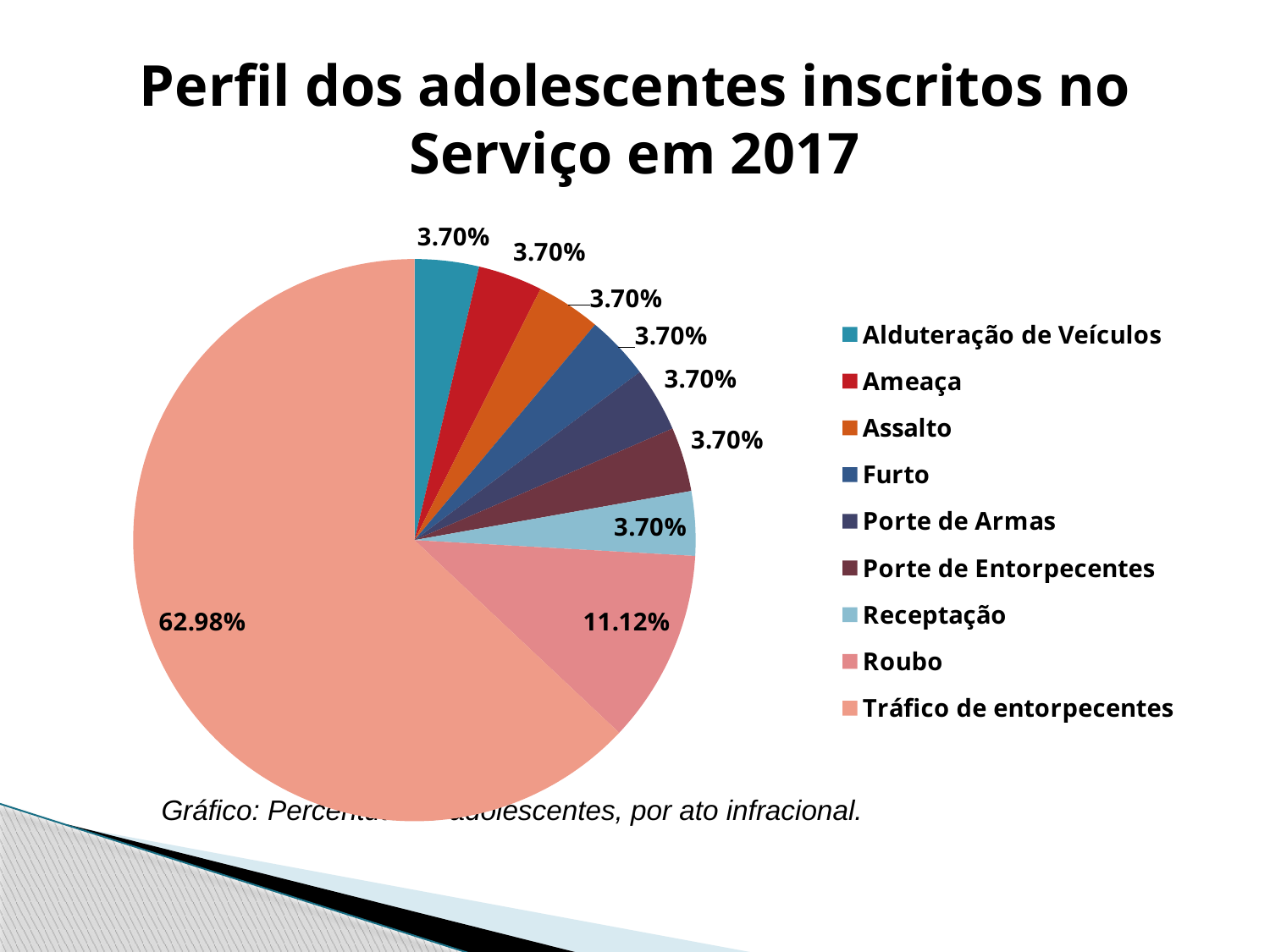
Which category has the largest slice of the pie? Tráfico de entorpecentes Which legend entry is listed first? Alduteração de Veículos What is the difference between the shares for Roubo and Ameaça? 7.42% What share of the pie does Tráfico de entorpecentes represent? 62.98% What share of the pie does Receptação represent? 3.70% Which is larger, the slice for Roubo or the slice for Furto? Roubo What share of the pie does Roubo represent? 11.12% What is the title of the slide containing the chart? Perfil dos adolescentes inscritos no Serviço em 2017 What is the difference between the shares for Tráfico de entorpecentes and Roubo? 51.86% What kind of chart is shown on the slide? pie chart How many categories have a share of 3.70%? 7 How many categories does the legend list? 9